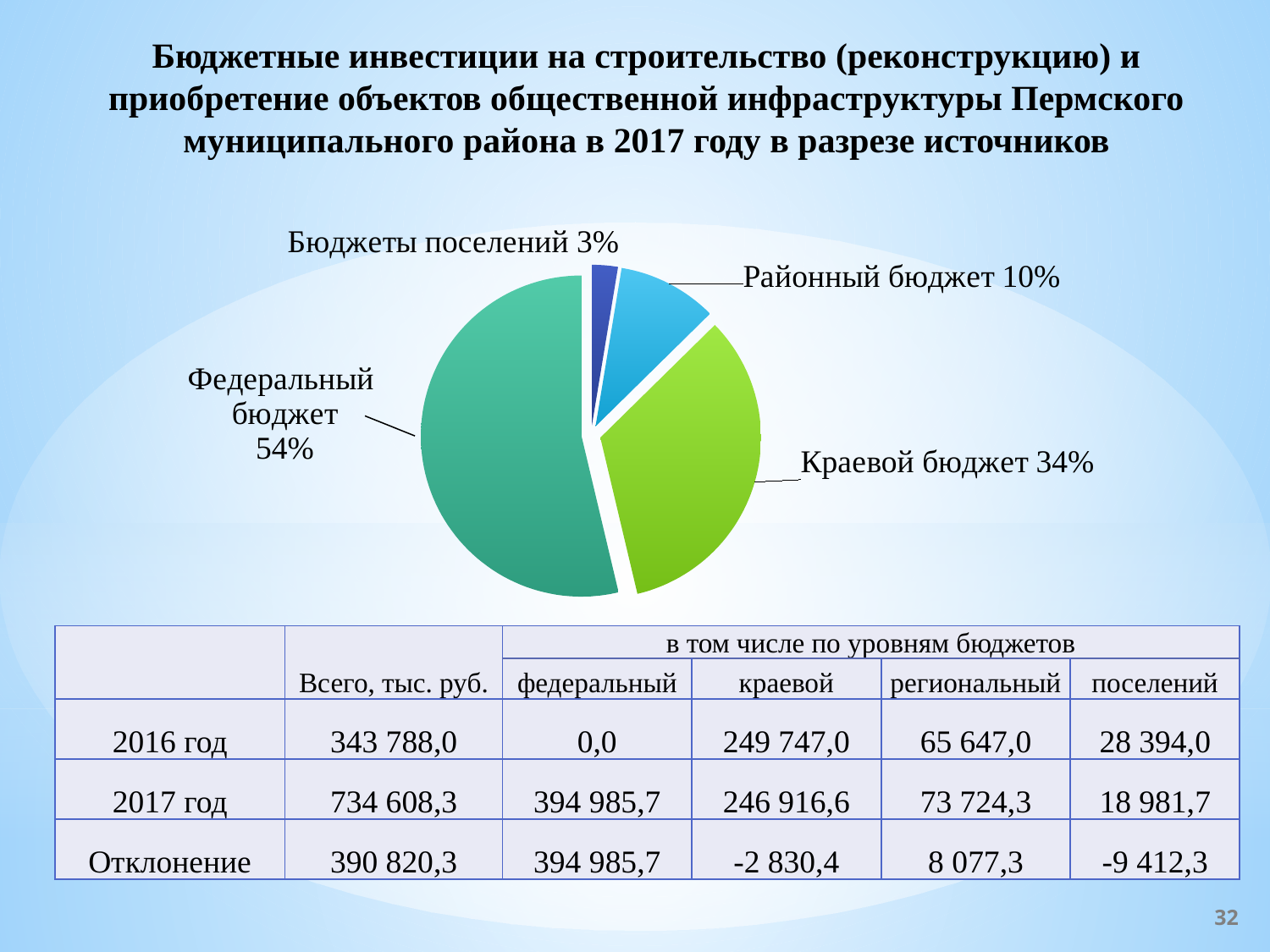
Which source has the smallest slice in the pie chart? Бюджеты поселений What type of chart is shown on the slide? Pie chart What is the difference in percentage points between the Районный бюджет and Бюджеты поселений slices? 7 What colour is the Краевой бюджет slice in the pie chart? Light green Which slice is larger: Районный бюджет or Бюджеты поселений? Районный бюджет What share of the pie chart does Районный бюджет account for? 10% What share of the pie chart does Краевой бюджет account for? 34% What is the difference in percentage points between the Федеральный бюджет and Краевой бюджет slices? 20 What share of the pie chart does Бюджеты поселений account for? 3% Which source has the largest slice in the pie chart? Федеральный бюджет How many slices does the pie chart have? 4